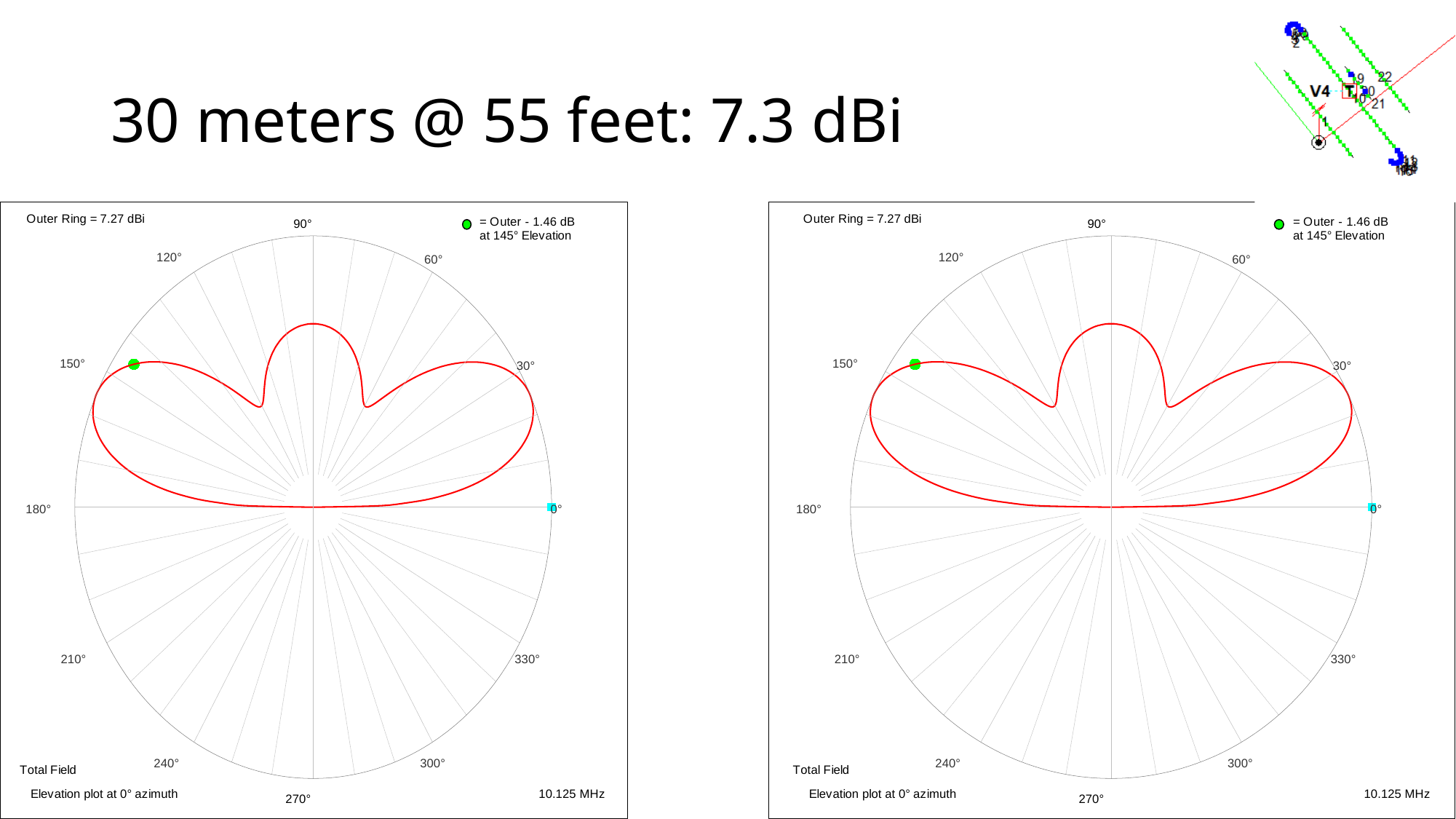
What is the title of the slide? 30 meters @ 55 feet: 7.3 dBi On the left chart, at what frequency is the pattern plotted? 10.125 MHz On the right chart, at what elevation is the green marker placed? 145° On the left chart, how many dB below the outer ring is the green marker? 1.46 dB On the left chart, what value does the outer ring represent? 7.27 dBi How many charts are on the slide? 2 What gain in dBi is stated in the slide title? 7.3 dBi What kind of chart is shown on the left of the slide? polar plot Is the outer ring value of the left chart larger than, smaller than, or equal to that of the right chart? equal What field type is labelled in the bottom-left corner of the left chart? Total Field On the right chart, what value does the outer ring represent? 7.27 dBi On the right chart, at what azimuth is the elevation plot taken? 0°